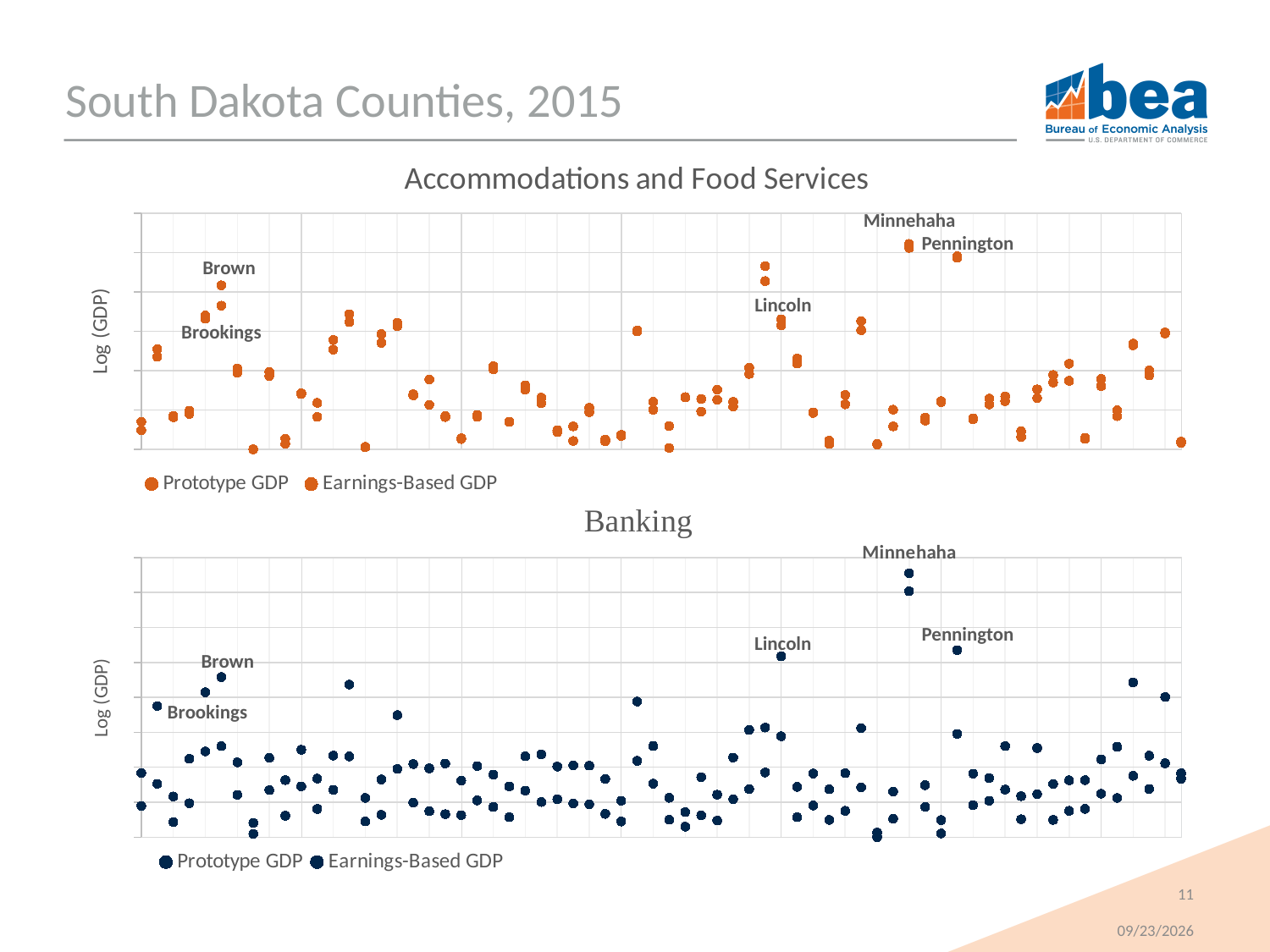
What kind of chart is the "Accommodations and Food Services" chart? Scatter chart What is the y-axis label of the "Banking" chart? Log (GDP) How many series does the legend of the "Accommodations and Food Services" chart list? 2 In the "Banking" chart, which labeled county has the highest Log (GDP) values? Minnehaha In the "Banking" chart, which labeled county is higher, Lincoln or Brookings? Lincoln What kind of chart is the "Banking" chart? Scatter chart In the "Banking" chart, which labeled county is higher, Minnehaha or Pennington? Minnehaha What are the two series named in the legend of the "Accommodations and Food Services" chart? Prototype GDP and Earnings-Based GDP How many series does the legend of the "Banking" chart list? 2 In the "Accommodations and Food Services" chart, which labeled county is higher, Brown or Brookings? Brown In the "Accommodations and Food Services" chart, which labeled county has the highest Log (GDP) values? Minnehaha